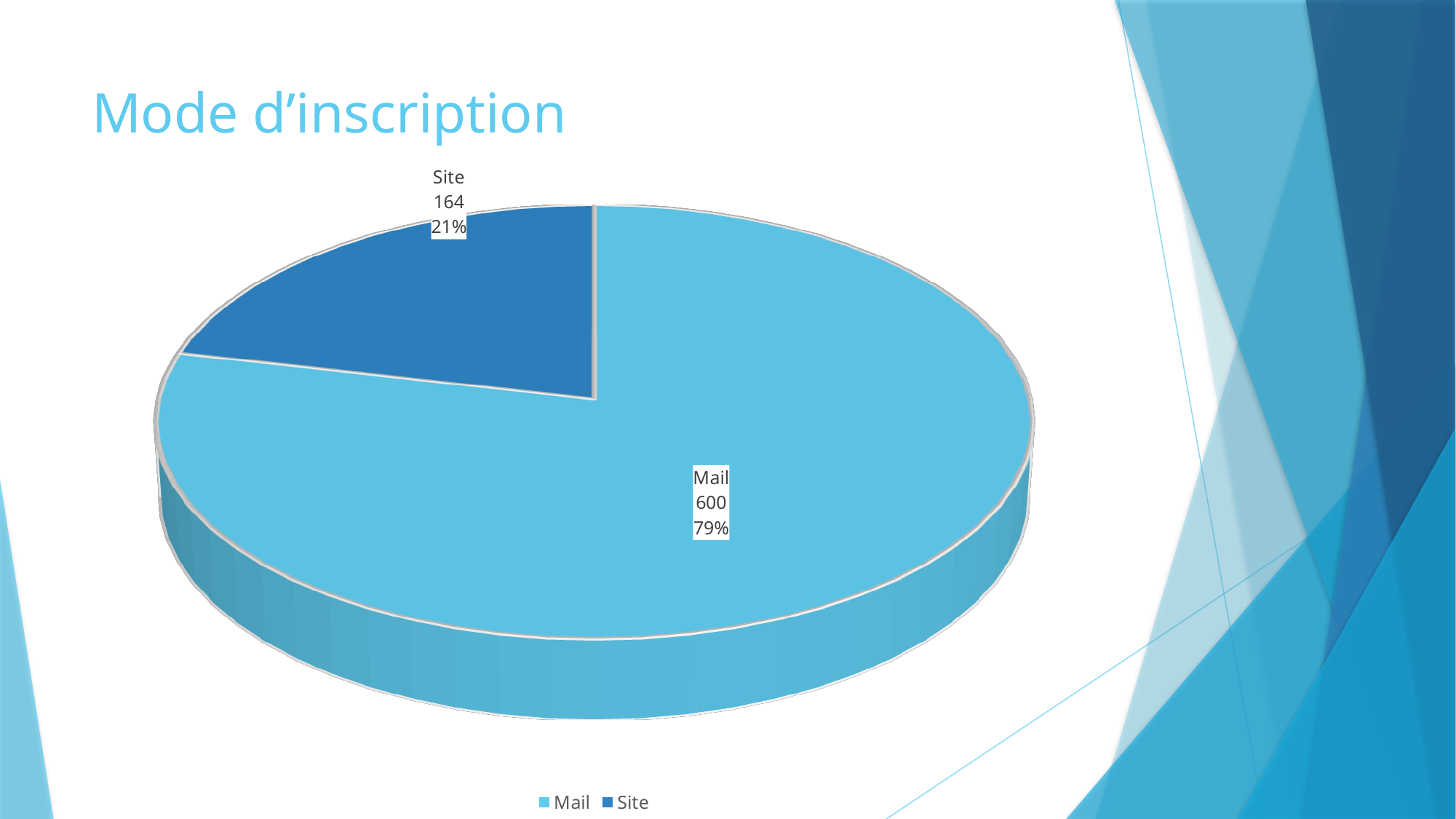
Which category has the smallest slice? Site How many categories does the pie chart show? 2 What percentage share does the Mail slice have? 79% What percentage share does the Site slice have? 21% Which category has the largest slice? Mail What is the value for Mail? 600 Which is larger, the value for Mail or the value for Site? Mail What is the title of the slide? Mode d’inscription What is the total of the two values shown in the pie chart? 764 What kind of chart is shown on the slide? Pie chart What is the value for Site? 164 What is the difference between the Mail value and the Site value? 436